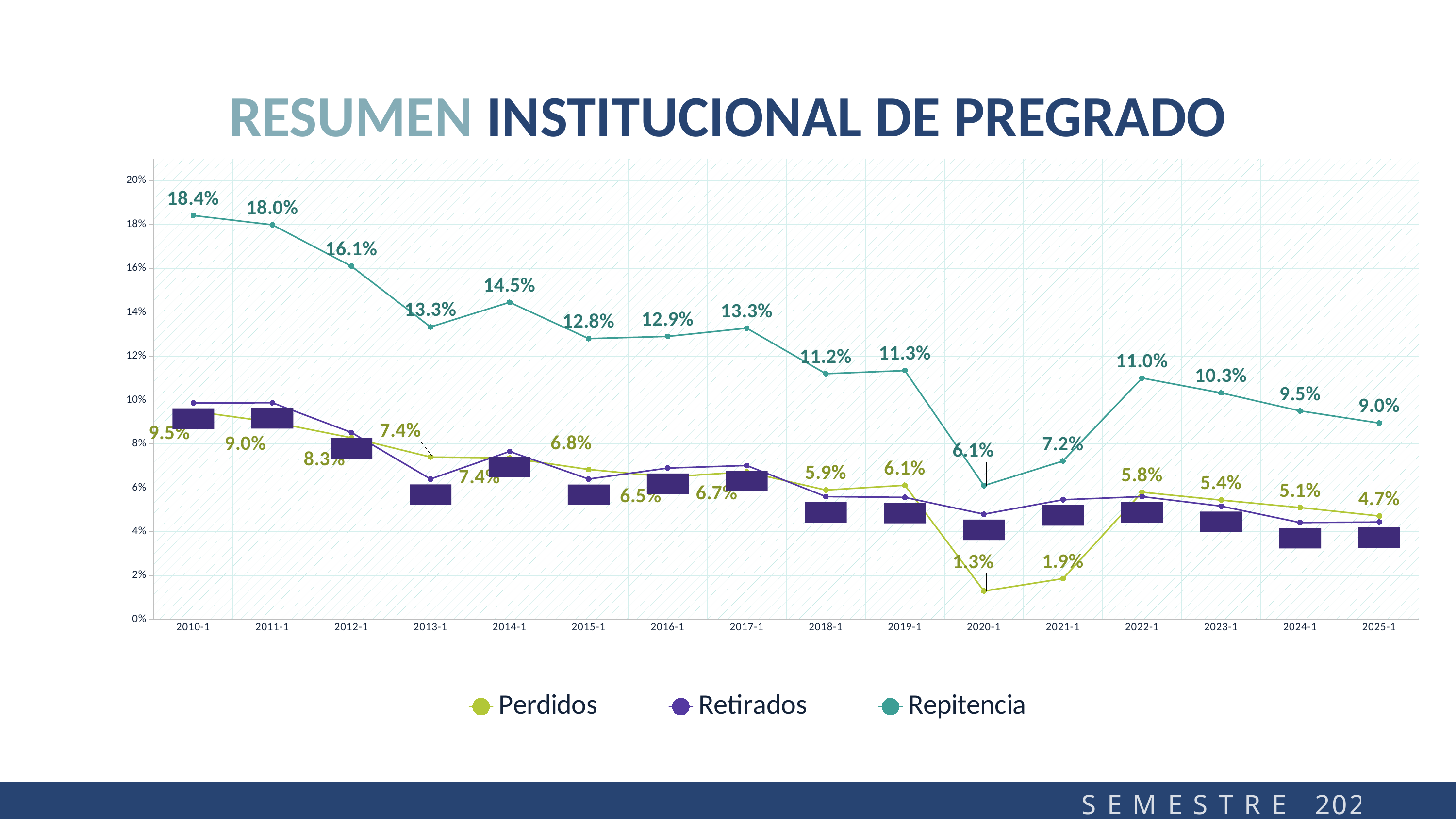
In which semester is the Repitencia value lowest? 2020-1 What kind of chart is shown on the slide? line chart What is the Repitencia value for 2010-1? 18.4% What is the difference between the Repitencia values for 2010-1 and 2025-1? 9.4% What is the Repitencia value for 2025-1? 9.0% What is the Perdidos value for 2020-1? 1.3% What is the Perdidos value for 2022-1? 5.8% In which semester is the Perdidos value highest? 2010-1 Is the Retirados value for 2010-1 greater or less than 8%? greater How many series does the legend list? 3 How many semesters are shown on the x axis? 16 Which is larger, the Repitencia value for 2014-1 or for 2013-1? 2014-1